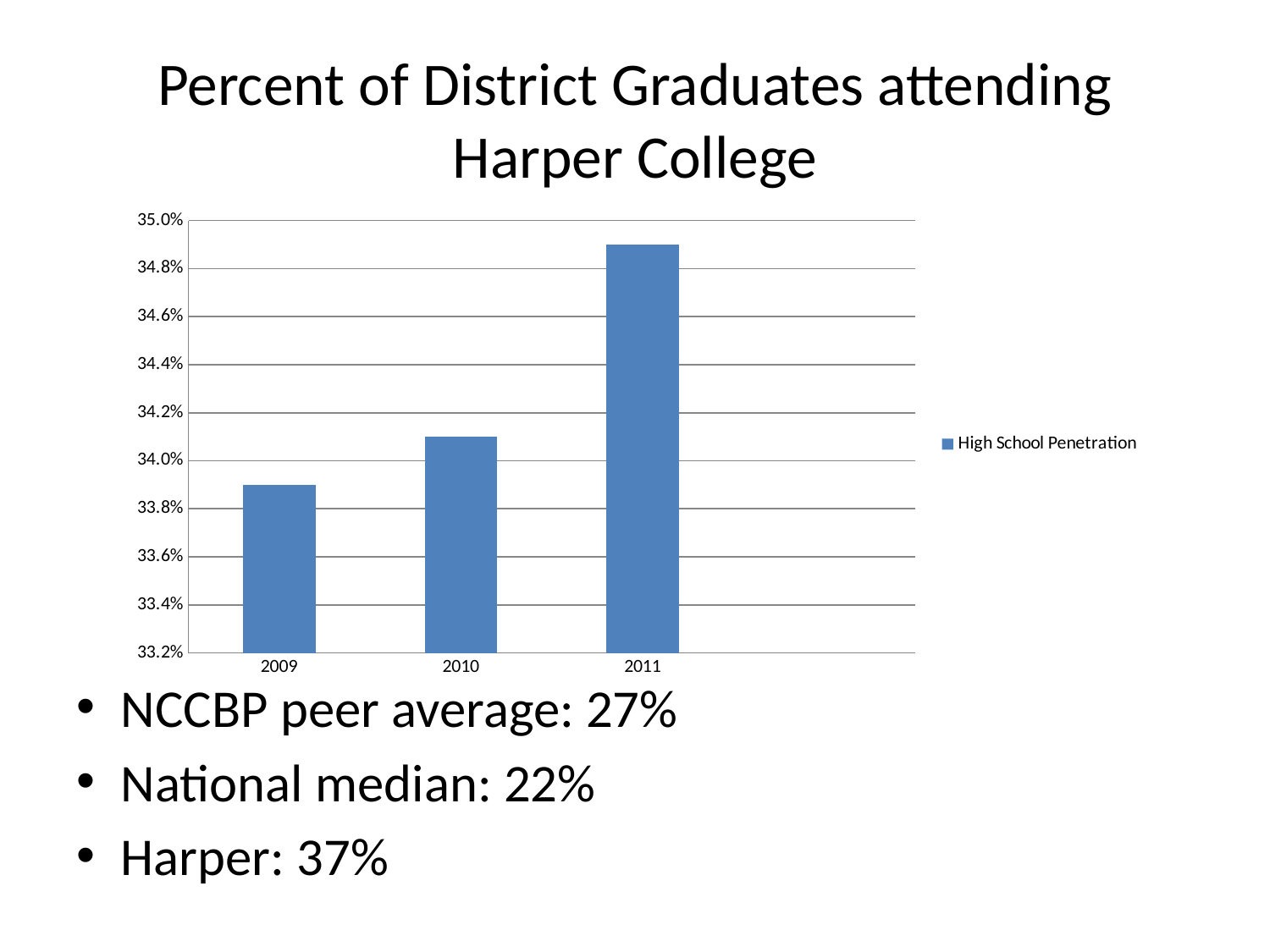
Do the High School Penetration values rise or fall from 2009 to 2011? rise Is the High School Penetration value for 2009 greater or less than 34.0%? less Which year has the highest High School Penetration value? 2011 What is the name of the series shown in the chart legend? High School Penetration Is the High School Penetration value for 2011 greater or less than 34.8%? greater How many years are plotted on the x axis of the chart? 3 How many series does the chart legend list? 1 Is the High School Penetration value for 2010 greater or less than 34.0%? greater What is the title of the chart on the slide? Percent of District Graduates attending Harper College Which year has a larger High School Penetration value, 2010 or 2011? 2011 Which year has the lowest High School Penetration value? 2009 What kind of chart is shown on the slide? bar chart